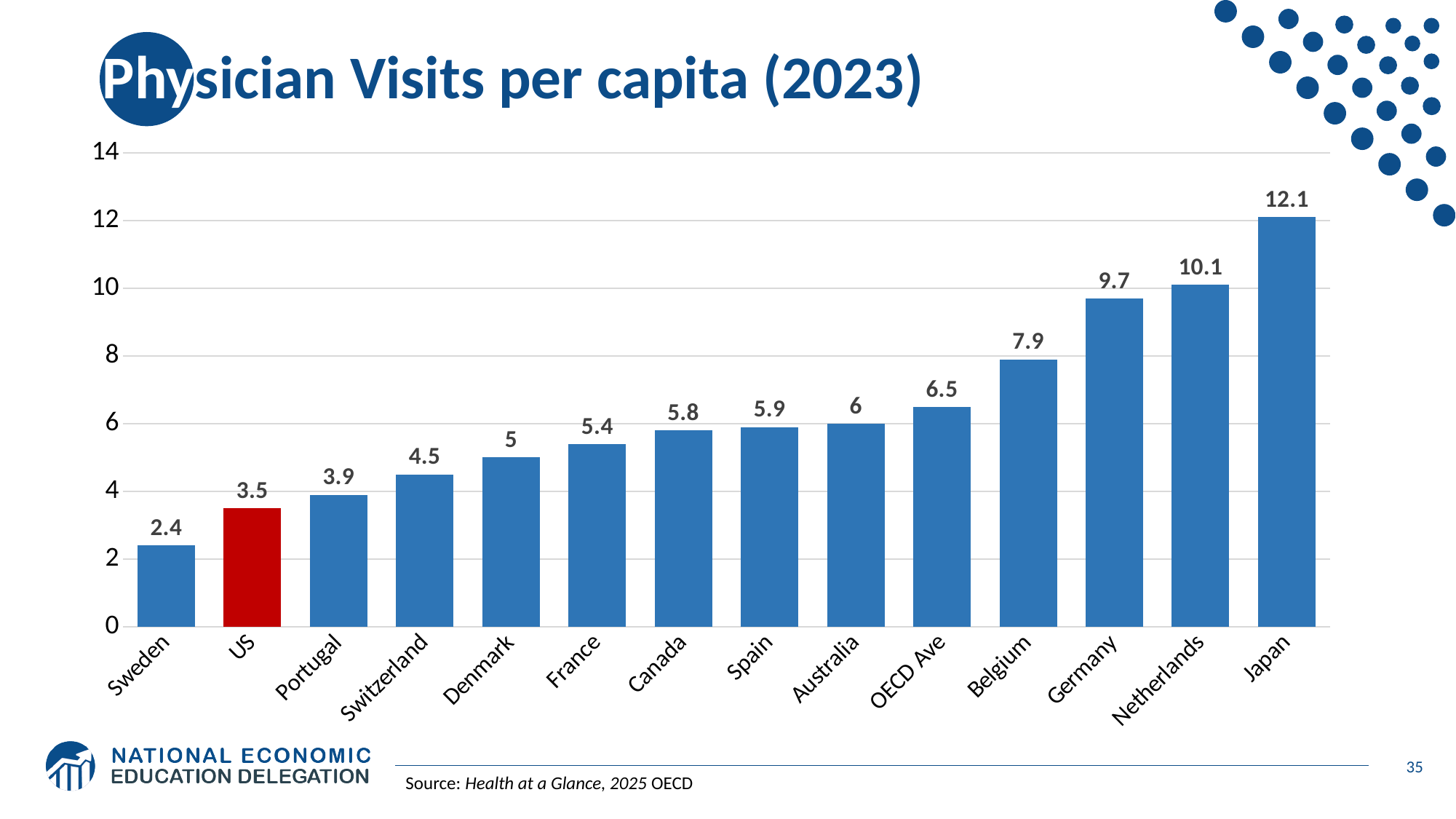
What is the value for the OECD Ave? 6.5 What kind of chart is this? Bar chart Do the values rise or fall from left to right along the x axis? Rise What is the value for Japan? 12.1 Which country has the highest number of physician visits per capita? Japan What is the difference between the values for Japan and the US? 8.6 Which country has the lowest number of physician visits per capita? Sweden Which bar is coloured red instead of blue? US What is the value for the US? 3.5 How many categories are shown on the x axis? 14 Which is larger, the value for Germany or the value for Netherlands? Netherlands What is the difference between the OECD Ave and the US? 3